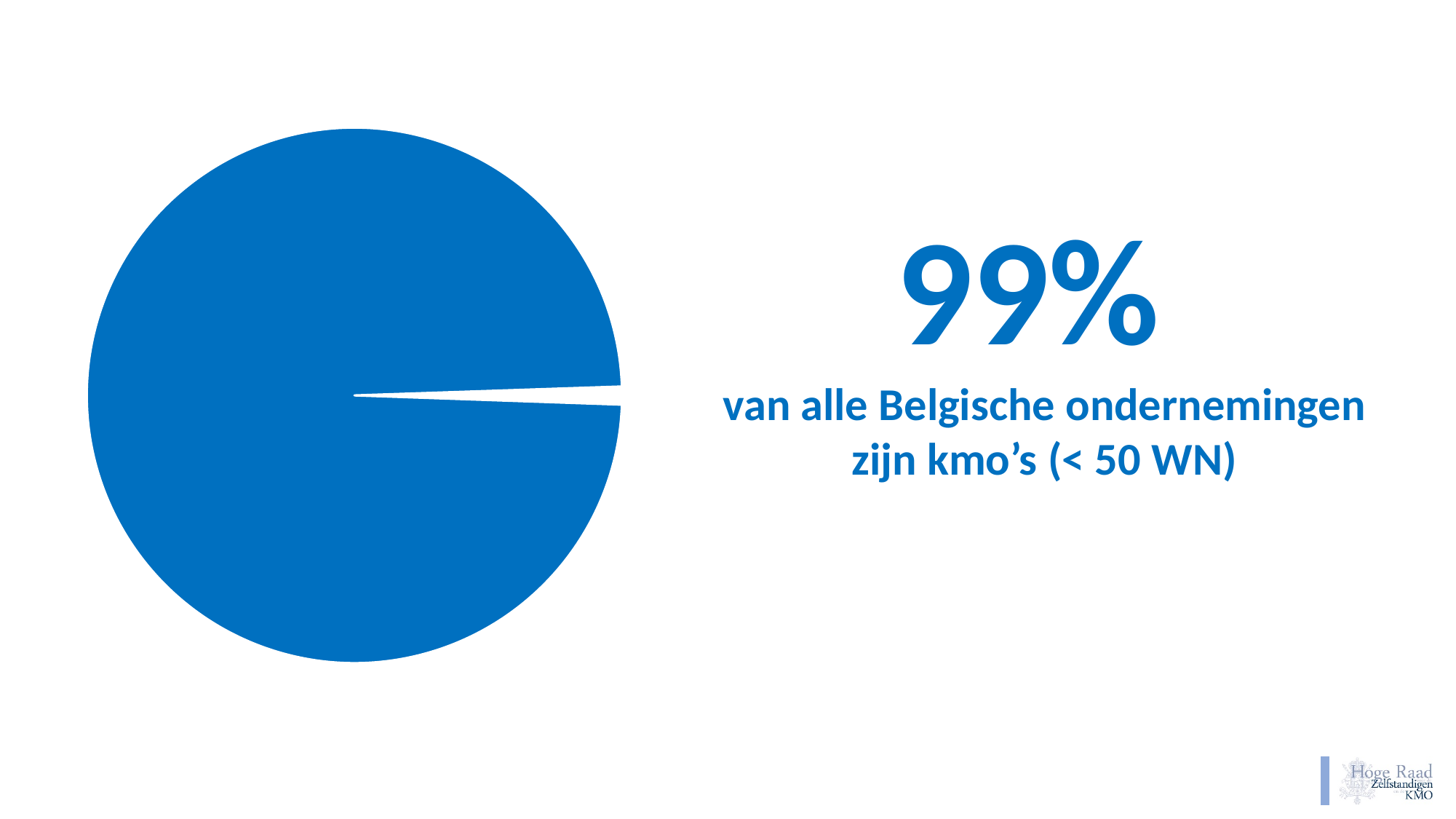
How many slices does the pie chart have? 2 According to the text next to the pie chart, what does the 99% slice represent? Belgian enterprises that are SMEs (kmo's, < 50 WN) What share of the pie does the thin white sliver represent, given the blue slice is 99%? 1% What kind of chart is shown on the slide? pie chart What colour is the large slice of the pie chart? blue What share of all Belgian enterprises does the large blue slice of the pie represent? 99% Which slice of the pie is larger, the blue slice or the thin white sliver? the blue slice Is the share represented by the large blue slice greater or less than 50%? greater